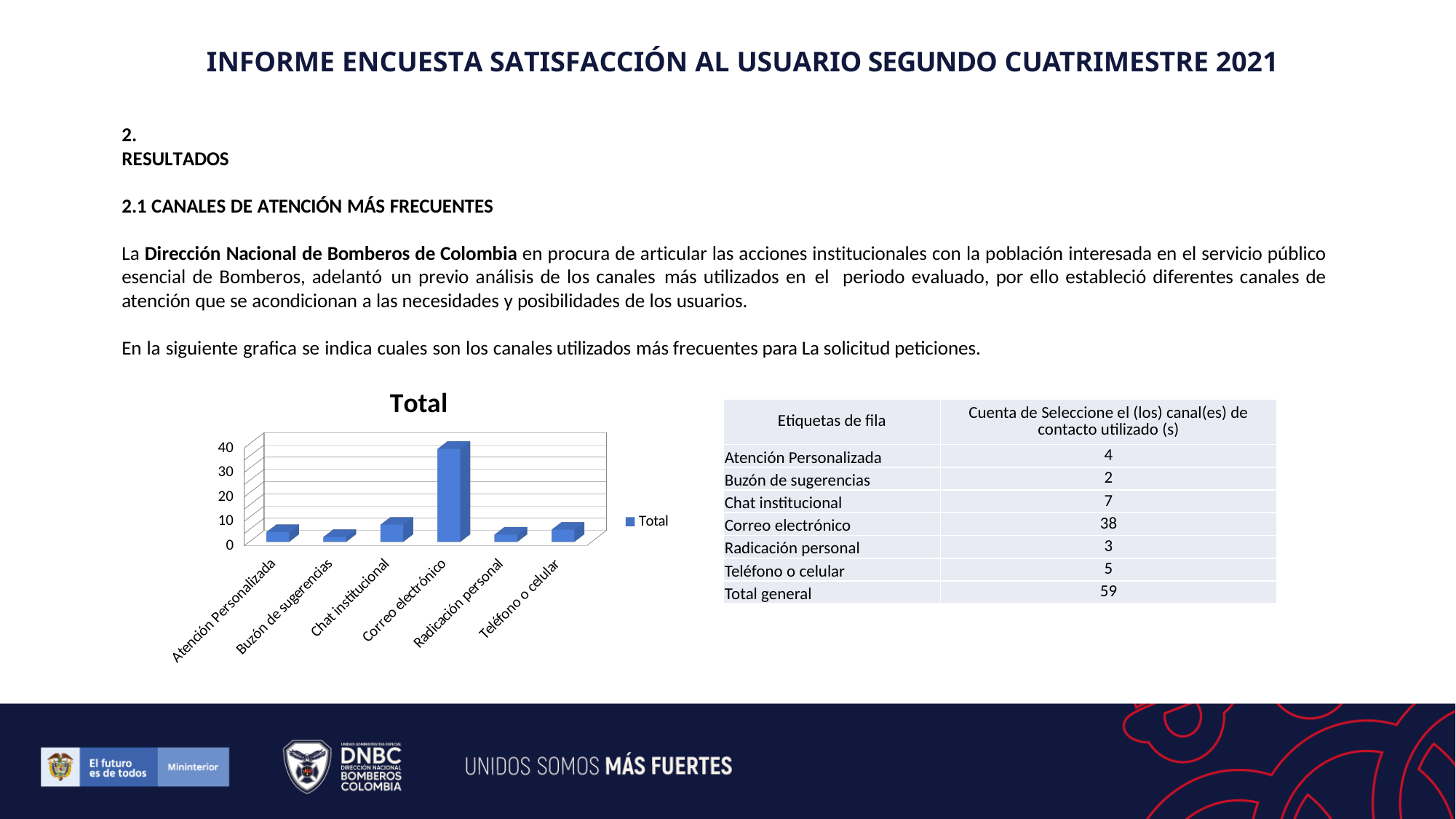
Is the value for Chat institucional greater or less than 10? less Is the value for Correo electrónico greater or less than 30? greater What kind of chart is shown on the slide? bar chart Which category has the highest bar in the chart? Correo electrónico What is the value for Teléfono o celular? 5 What is the title of the chart? Total Which is larger, the value for Chat institucional or the value for Buzón de sugerencias? Chat institucional What is the value for Correo electrónico? 38 How many categories are shown on the x axis of the chart? 6 How many series does the chart legend list? 1 What is the difference between the value for Correo electrónico and the value for Chat institucional? 31 Which category has the lowest bar in the chart? Buzón de sugerencias